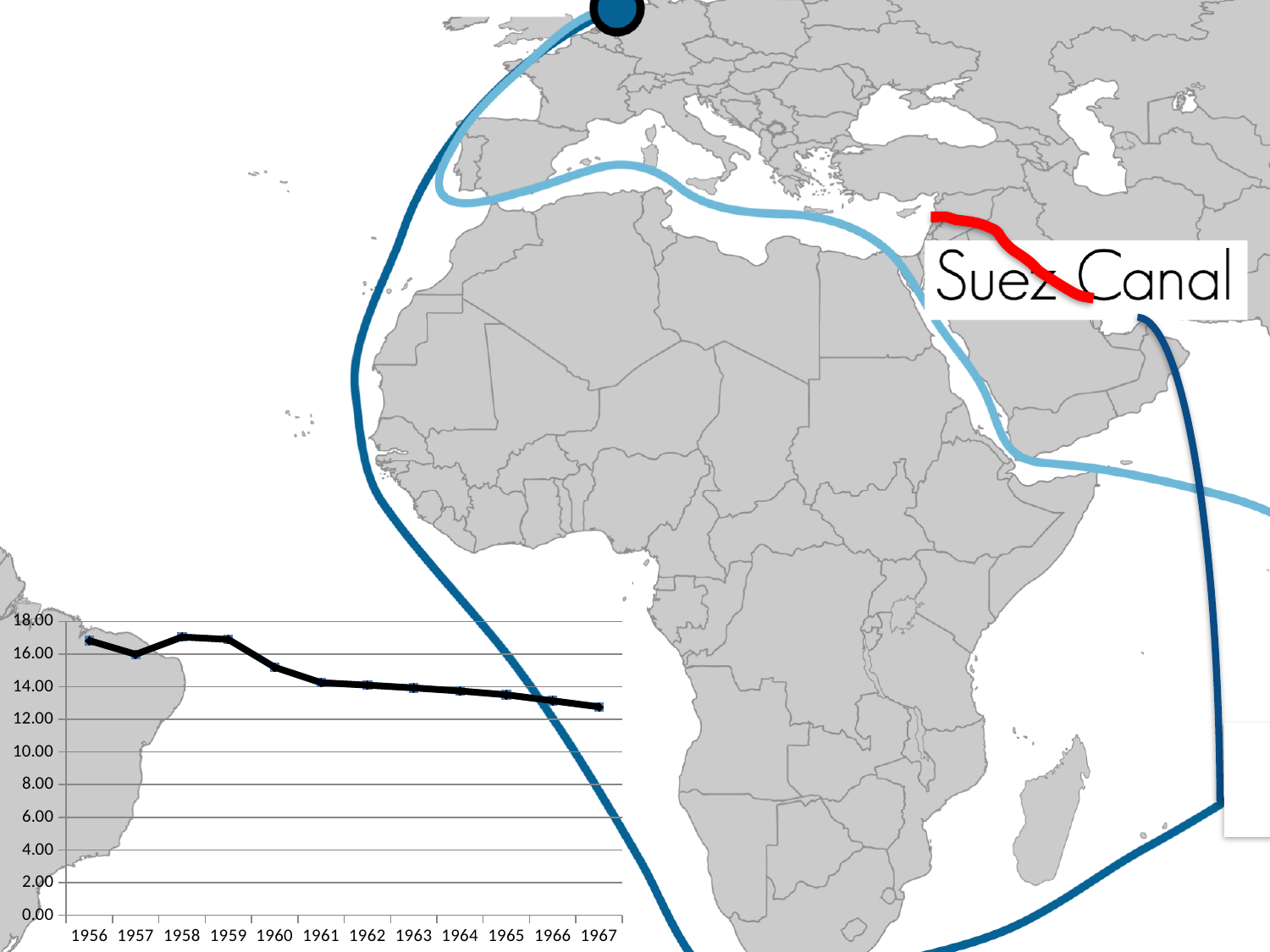
Is the value for 1960 greater or less than 14.00? greater Do the values in the line chart generally rise or fall from 1956 to 1967? fall Is the value for 1956 greater or less than 16.00? greater Which year has the larger value, 1956 or 1957? 1956 What is the highest tick value shown on the y axis of the line chart? 18.00 Is the value for 1958 greater or less than 16.00? greater How many years are plotted on the x axis of the line chart? 12 Which year has the larger value, 1960 or 1961? 1960 What kind of chart is shown at the bottom left of the slide? line chart